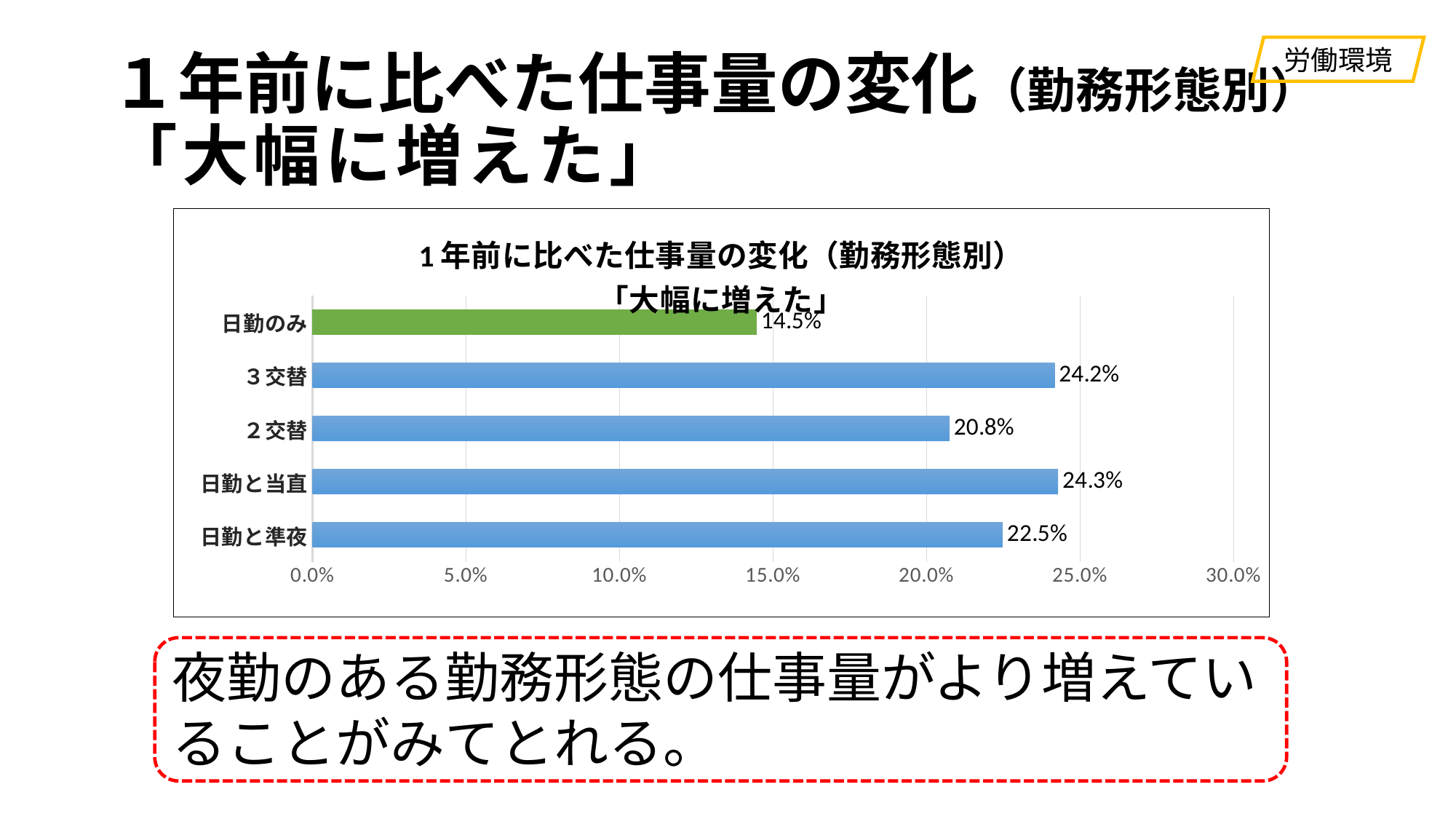
Is the value for 日勤のみ greater or less than 20.0%? less What is the value for ３交替? 24.2% What is the value for 日勤と準夜? 22.5% How many categories are shown in the chart? 5 What is the difference between the values for ３交替 and ２交替? 3.4 percentage points Which is larger, the value for 日勤と準夜 or the value for ２交替? 日勤と準夜 What is the value for ２交替? 20.8% What is the difference between the values for 日勤と当直 and 日勤のみ? 9.8 percentage points Which category has the lowest value? 日勤のみ What is the value for 日勤と当直? 24.3% What is the value for 日勤のみ? 14.5% What kind of chart is shown on the slide? bar chart